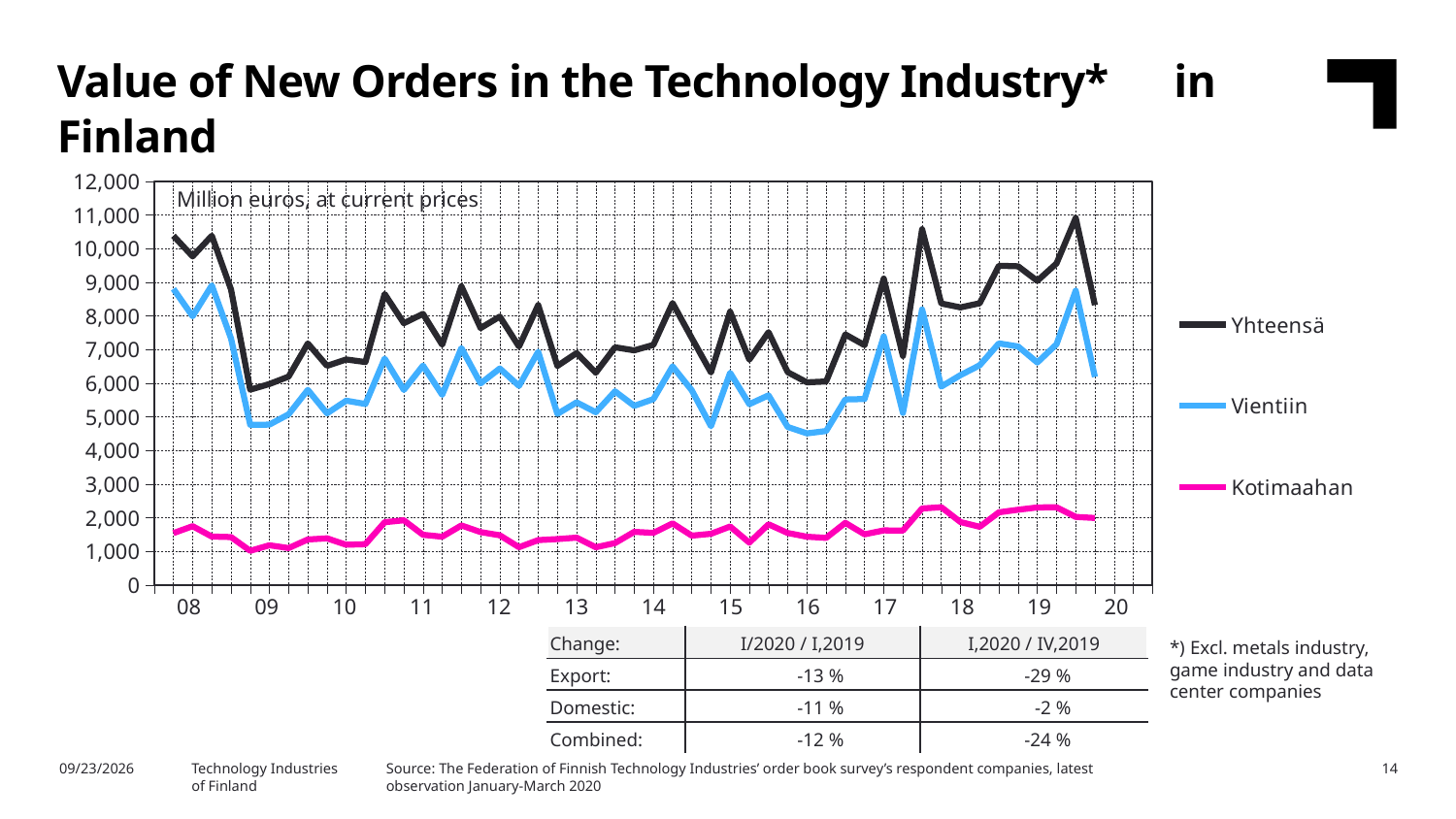
How many year labels are shown on the x axis? 13 Does the Yhteensä series rise or fall between 2008 and 2009? fall Which series is larger in 2018, Vientiin or Kotimaahan? Vientiin Is the lowest value for Vientiin in 2009 greater or less than 6,000? less Is the value for Yhteensä at the start of 2008 greater or less than 9,000? greater How many series does the legend list? 3 What unit note is printed inside the chart area? Million euros, at current prices Is the value for Kotimaahan in 2015 greater or less than 3,000? less Which series is shown in pink in the chart? Kotimaahan What kind of chart is shown on the slide? line chart Which series has the lowest values throughout the whole period? Kotimaahan